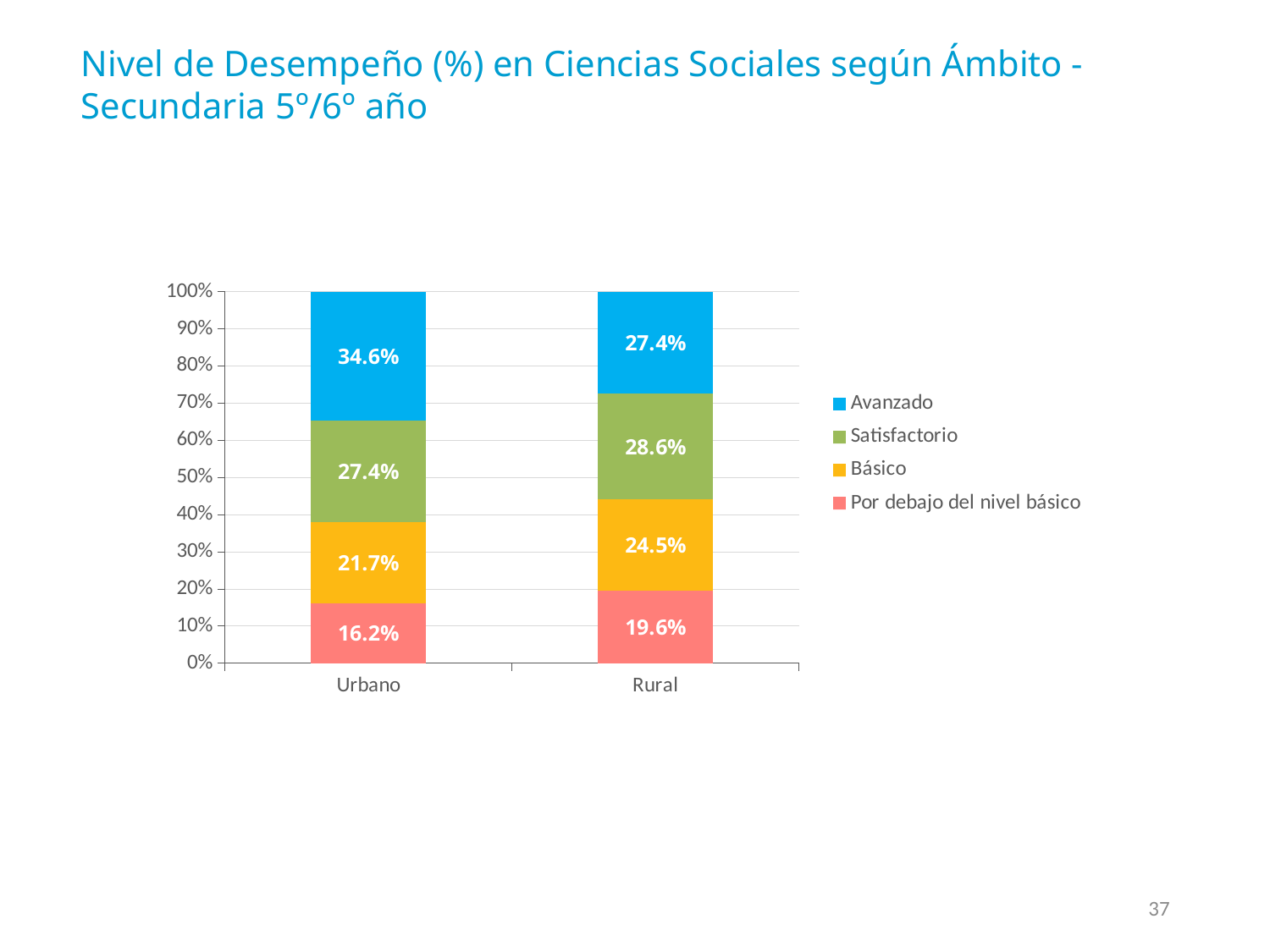
What is the difference between the Básico values for Rural and Urbano? 2.8% How many series does the legend list? 4 What is the Satisfactorio value for Rural? 28.6% How many categories are shown on the x axis? 2 Which category has the higher Por debajo del nivel básico value, Urbano or Rural? Rural What is the Por debajo del nivel básico value for Urbano? 16.2% Which category has the higher Avanzado value, Urbano or Rural? Urbano What is the Básico value for Rural? 24.5% What kind of chart is shown on the slide? Stacked bar chart Which series has the largest value within the Urbano bar? Avanzado What is the difference between the Avanzado values for Urbano and Rural? 7.2% What is the Avanzado value for Urbano? 34.6%